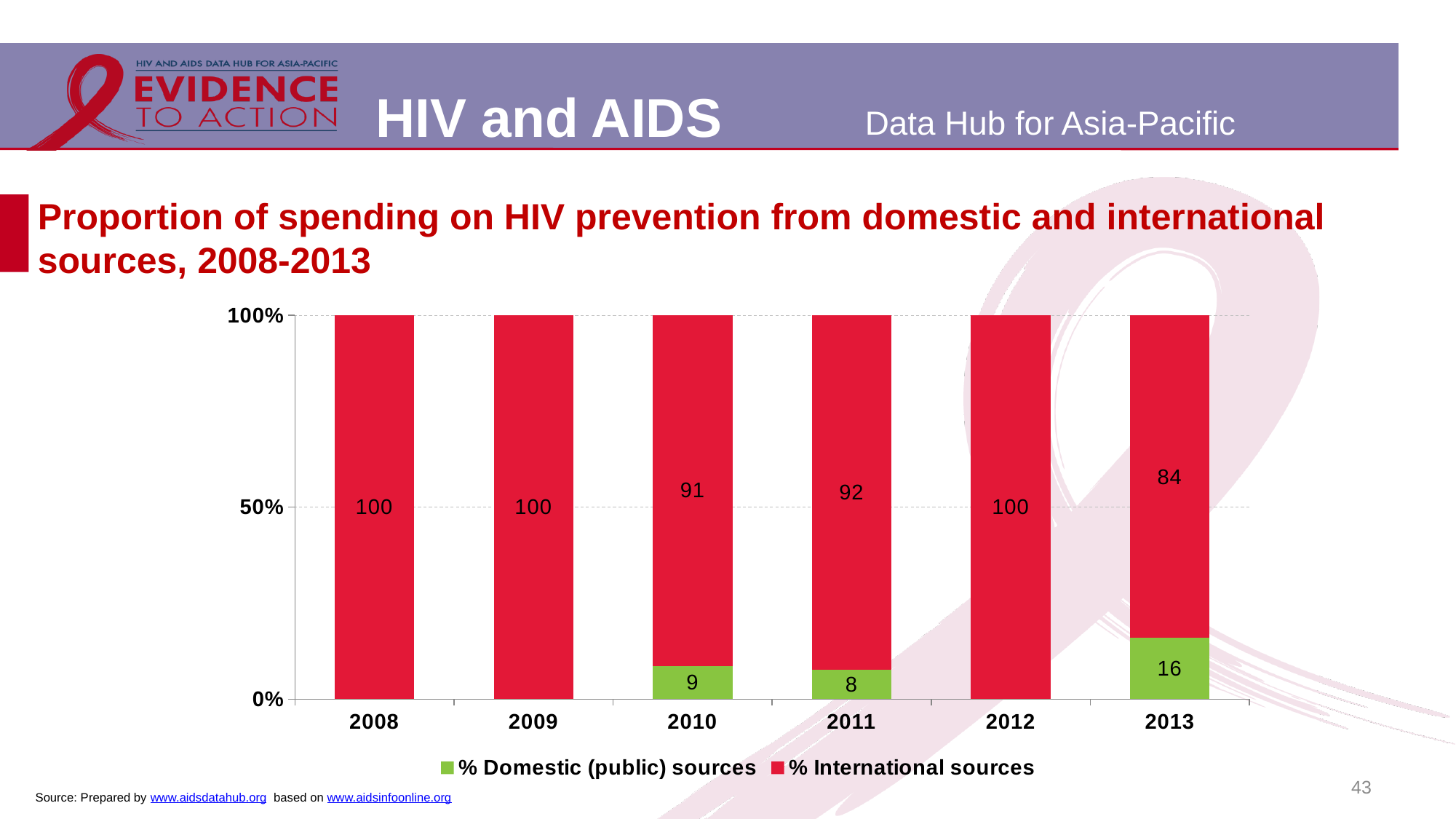
What is the value for % Domestic (public) sources in 2010? 9 How many series does the legend list? 2 Which year has the lowest value for % International sources? 2013 What is the value for % International sources in 2012? 100 Which year has the highest value for % Domestic (public) sources? 2013 What is the value for % Domestic (public) sources in 2011? 8 What kind of chart is shown on the slide? Stacked bar chart Which is larger, the % Domestic (public) sources value for 2010 or for 2011? 2010 What colour represents % International sources in the chart? Red What is the value for % International sources in 2013? 84 What is the difference between the % International sources values for 2012 and 2013? 16 How many years are shown on the x axis? 6